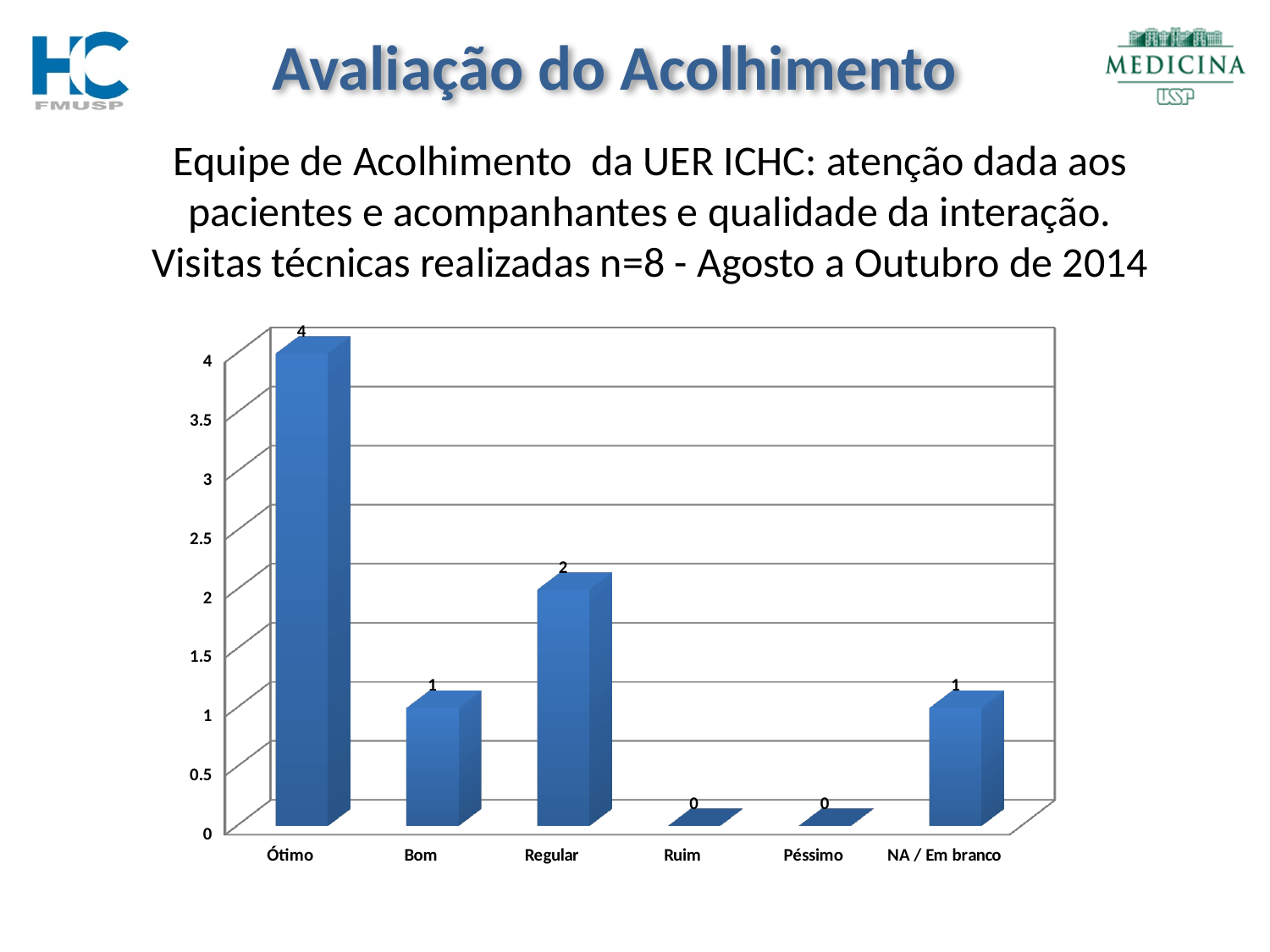
What is the value for Regular? 2 What is the value for Ótimo? 4 What is the total of the values for Ótimo, Bom and Regular? 7 Which is larger, the value for Regular or the value for Bom? Regular Which category has the highest value? Ótimo What is the difference between the values for Ótimo and Regular? 2 How many categories are shown on the x axis? 6 What is the value for Ruim? 0 How many categories have a value of 0? 2 What is the value for NA / Em branco? 1 What is the value for Bom? 1 What kind of chart is shown on the slide? Bar chart